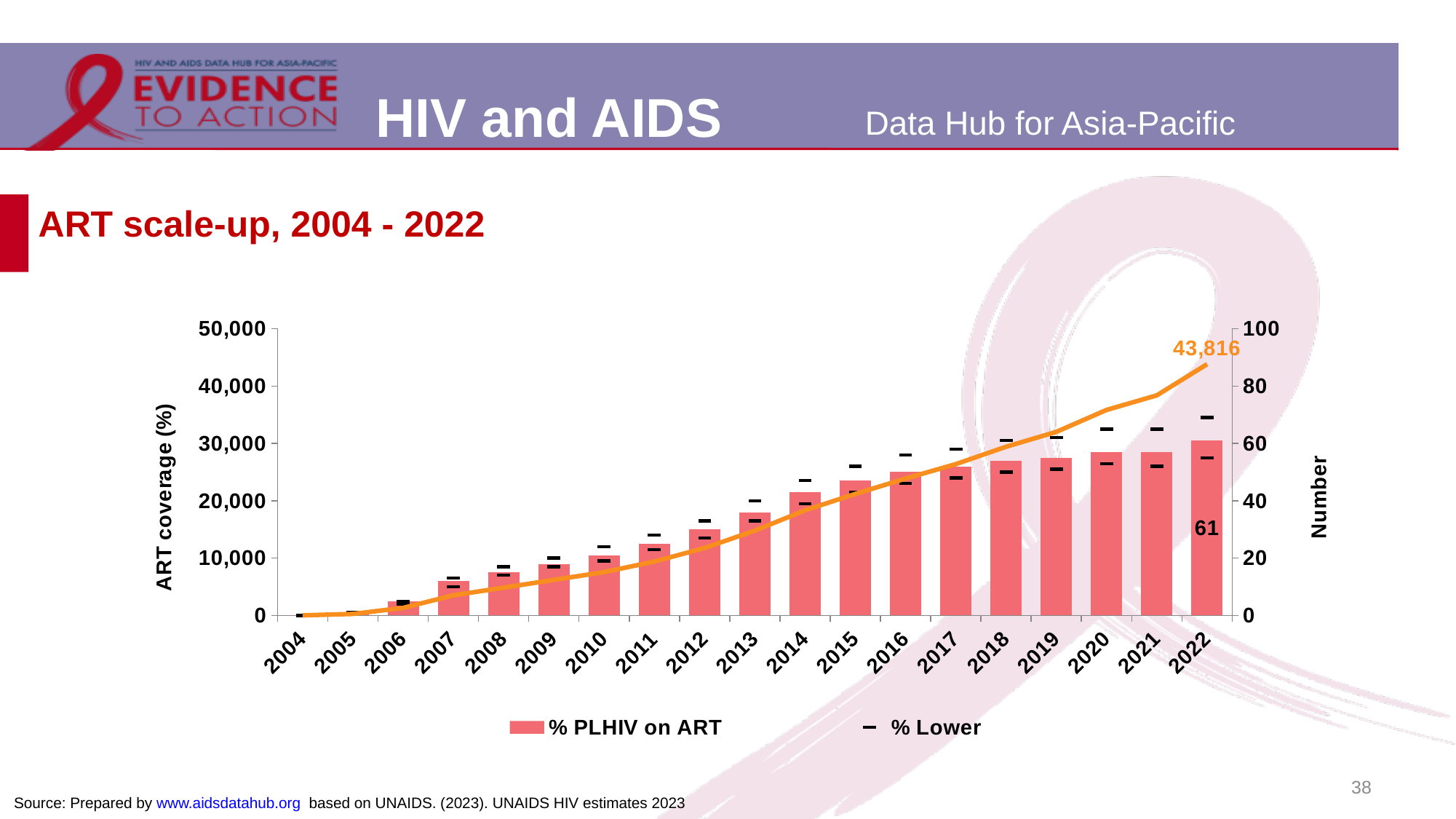
Is the % PLHIV on ART bar for 2018 greater or less than 40 on the right-hand axis? greater What is the data label shown on the % PLHIV on ART bar for 2022? 61 How many years are shown along the x axis? 19 What is the title of the chart? ART scale-up, 2004 - 2022 What kind of chart is this? bar chart with a line Is the % PLHIV on ART bar for 2010 greater or less than 40 on the right-hand axis? less What value is labelled on the orange line at 2022? 43,816 How many series does the legend list? 2 Which year has the lowest % PLHIV on ART bar? 2004 Which year has the larger % PLHIV on ART bar, 2009 or 2015? 2015 Do the % PLHIV on ART bars rise or fall from 2004 to 2022? rise Which year has the highest % PLHIV on ART bar? 2022